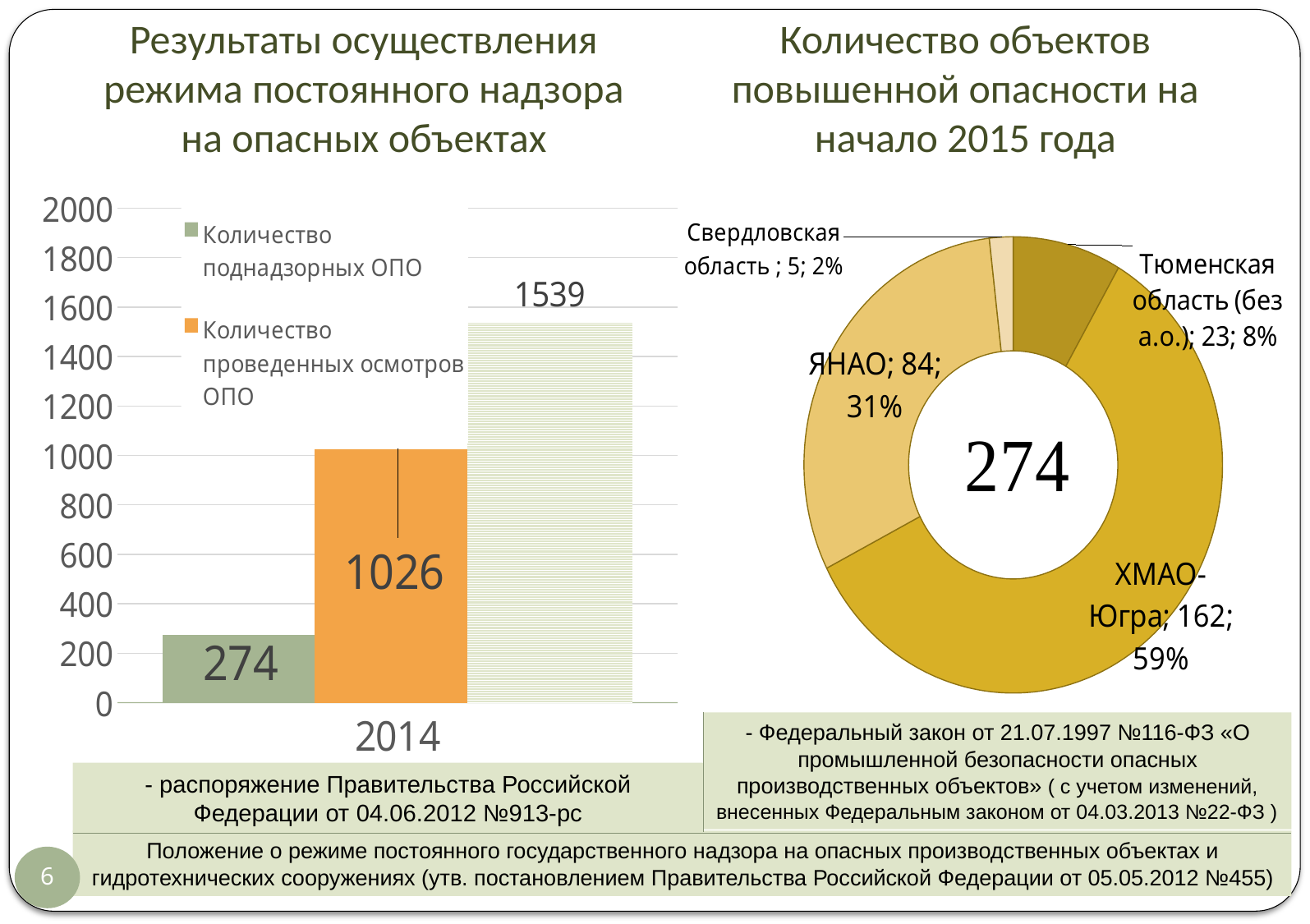
In the right chart, which has more objects: Тюменская область (без а.о.) or ЯНАО? ЯНАО In the right chart 'Количество объектов повышенной опасности на начало 2015 года', how many objects are in ХМАО-Югра? 162 In the right chart, what share of the total does ЯНАО account for? 31% In the left bar chart, how many series does the legend list? 2 In the left bar chart, what is the value shown above the tallest bar? 1539 In the right chart, which region has the smallest number of objects? Свердловская область What kind of chart is shown on the left side of the slide? Bar chart In the right chart, what total number is shown in the centre of the doughnut? 274 In the right chart, how many regions (slices) are shown? 4 In the left bar chart, what is the value for 'Количество проведенных осмотров ОПО' in 2014? 1026 In the left bar chart, what is the difference between the 'Количество проведенных осмотров ОПО' bar and the 'Количество поднадзорных ОПО' bar? 752 In the left bar chart, what is the value for 'Количество поднадзорных ОПО' in 2014? 274